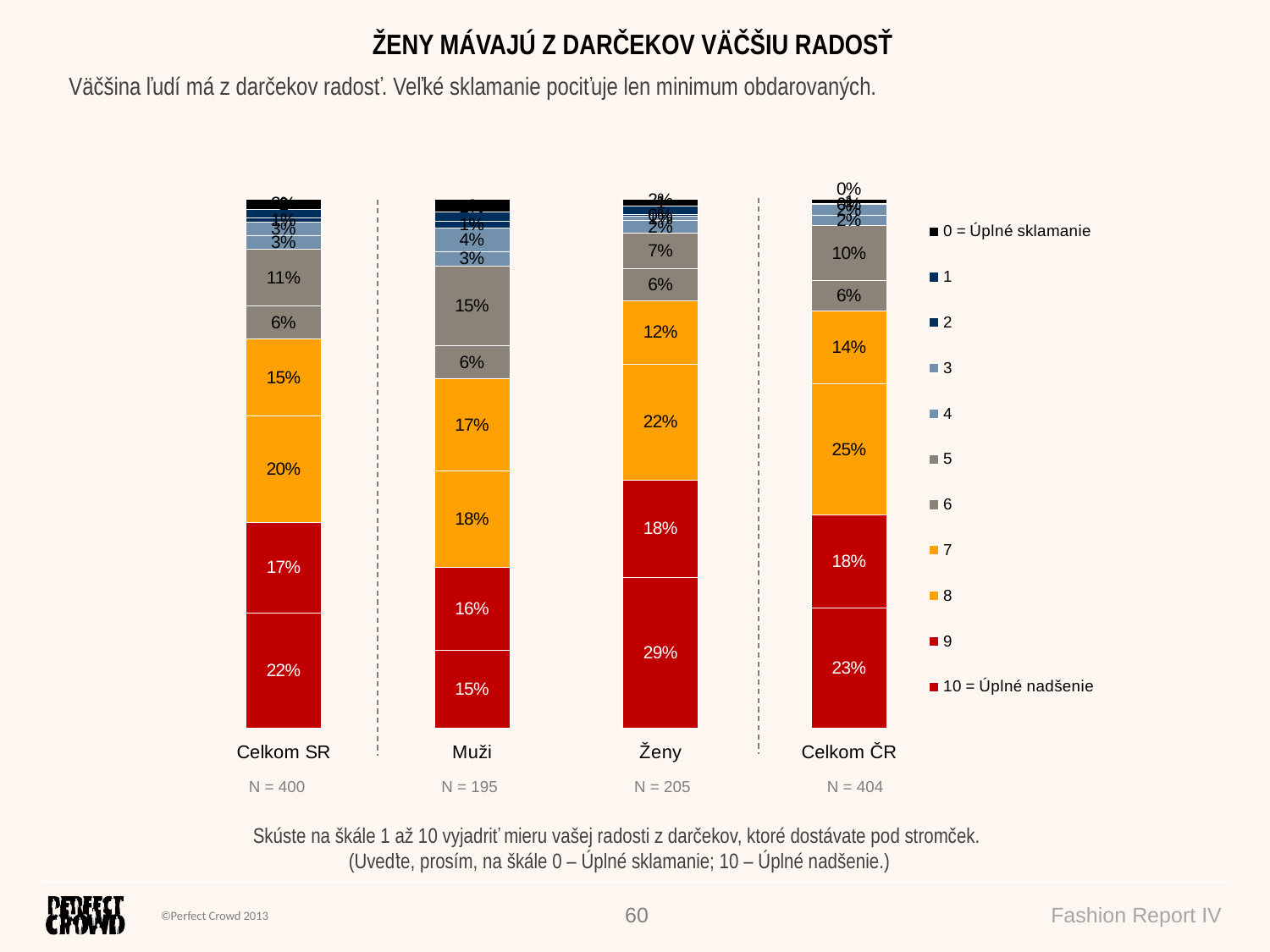
What is the value of the '5' segment for Celkom SR? 11% What is the value of the '8' segment for Celkom ČR? 25% Which category has the lowest value for '10 = Úplné nadšenie'? Muži What type of chart is shown on the slide? stacked bar chart What is the value of the '10 = Úplné nadšenie' segment for Celkom ČR? 23% Which category has the highest value for '10 = Úplné nadšenie'? Ženy How many series does the legend list? 11 Which is larger: the '7' segment for Muži or the '7' segment for Ženy? Muži What is the difference between the '10 = Úplné nadšenie' values for Ženy and Muži? 14% What is the value of the '10 = Úplné nadšenie' segment for Ženy? 29% How many bars (categories) are shown in the chart? 4 What is the value of the '10 = Úplné nadšenie' segment for Muži? 15%